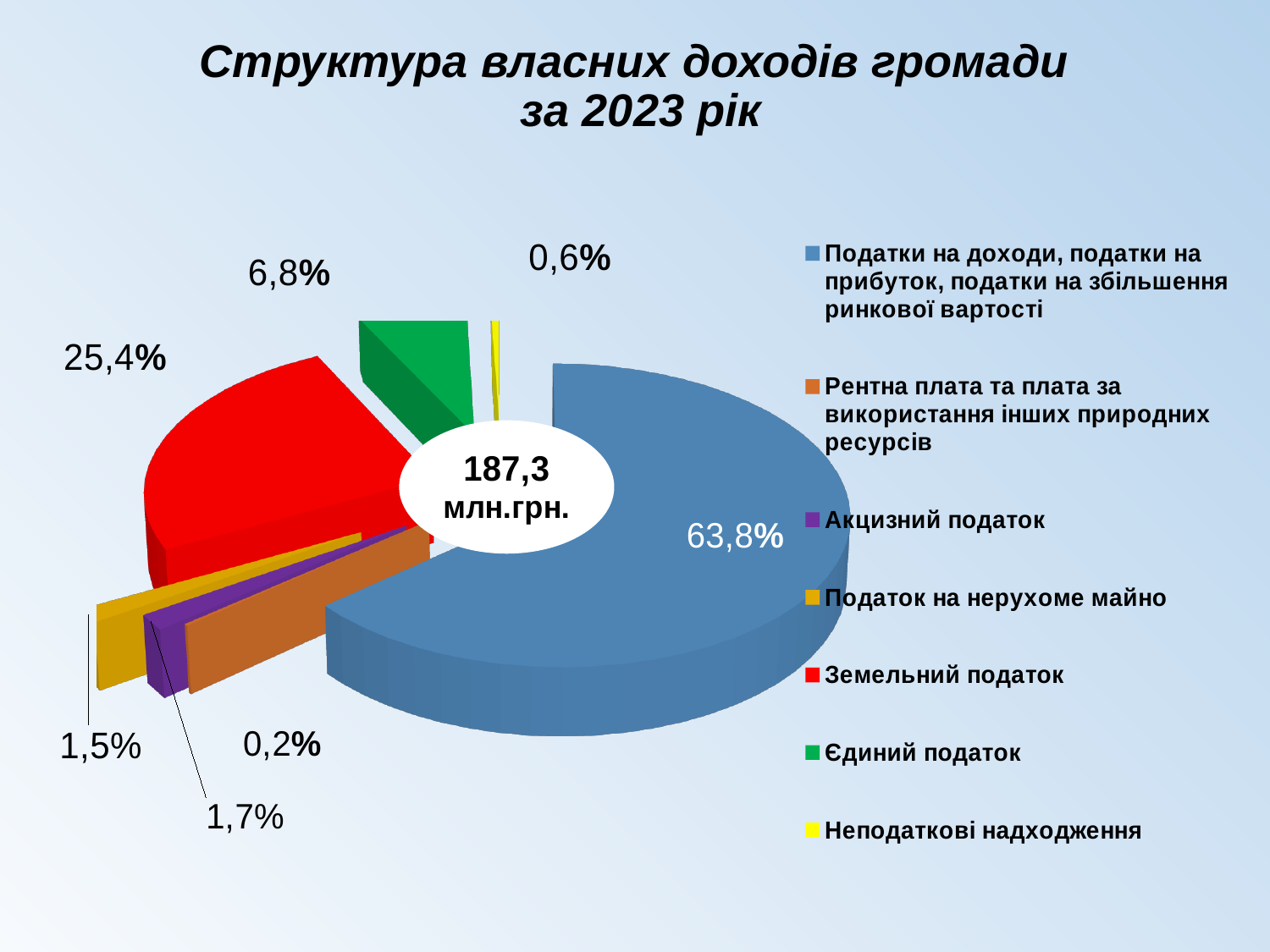
Which is larger: the share for "Земельний податок" or the share for "Єдиний податок"? Земельний податок What kind of chart is shown on the slide? pie chart How many categories does the legend list? 7 What share of the pie does "Неподаткові надходження" have? 0,6% What share of the pie does "Єдиний податок" have? 6,8% What share of the pie does "Земельний податок" have? 25,4% Which category has the smallest slice of the pie? Рентна плата та плата за використання інших природних ресурсів What colour is the slice for "Земельний податок"? red What total amount is shown in the centre of the pie chart? 187,3 млн.грн. What is the difference between the share for "Податки на доходи, податки на прибуток, податки на збільшення ринкової вартості" and the share for "Земельний податок"? 38,4% Which category has the largest slice of the pie? Податки на доходи, податки на прибуток, податки на збільшення ринкової вартості